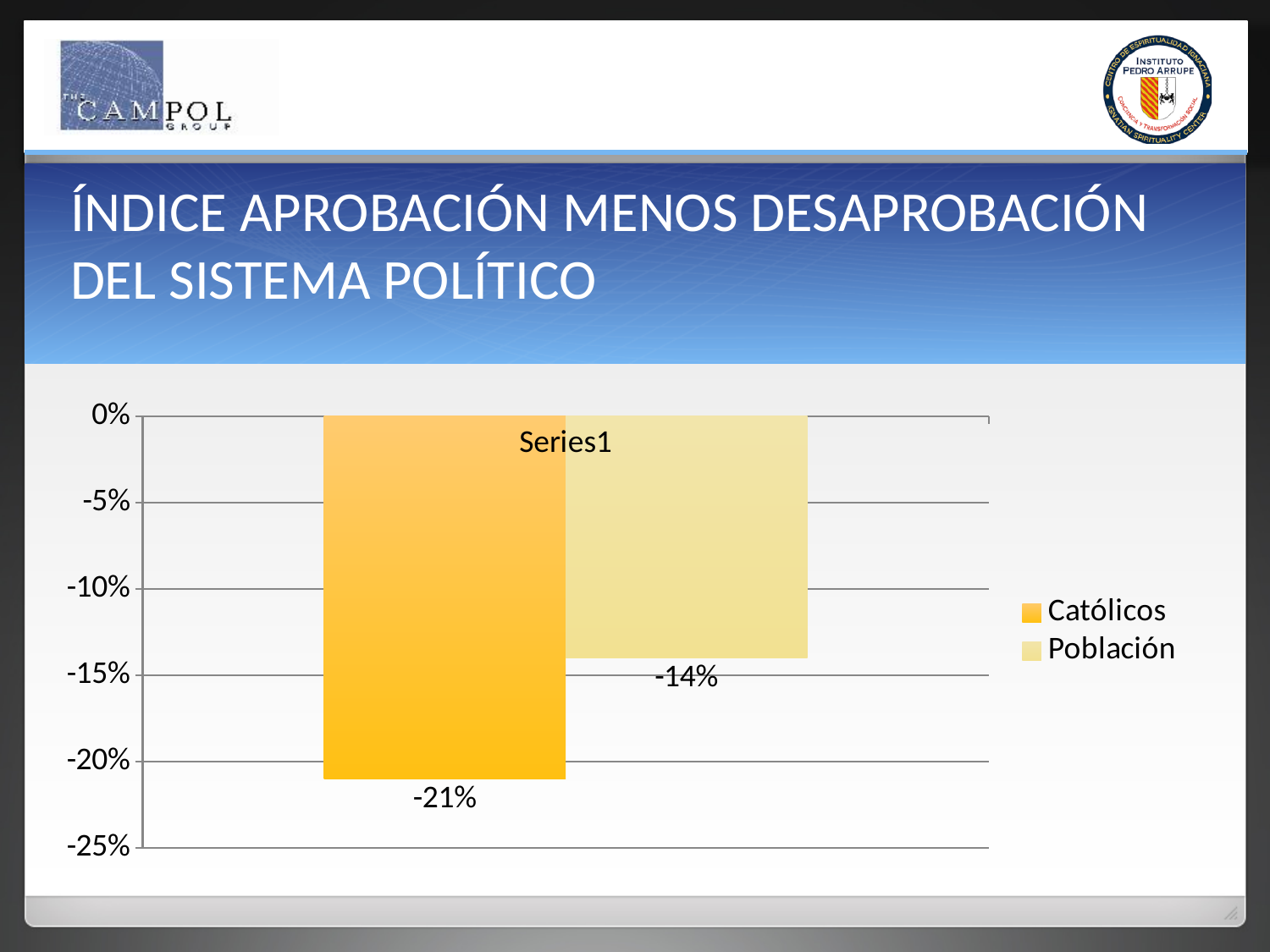
How many series does the legend list? 2 Which series has the highest value, Católicos or Población? Población Which series has the lowest value, Católicos or Población? Católicos Which value is larger, Católicos or Población? Población What is the difference between the values for Católicos and Población? 7% What is the title of the slide containing the chart? ÍNDICE APROBACIÓN MENOS DESAPROBACIÓN DEL SISTEMA POLÍTICO What category label is shown on the x axis of the chart? Series1 What kind of chart is shown on the slide? bar chart Is the value for Católicos greater or less than -20%? less What is the value for Católicos? -21% What is the value for Población? -14% Is the value for Población greater or less than -15%? greater